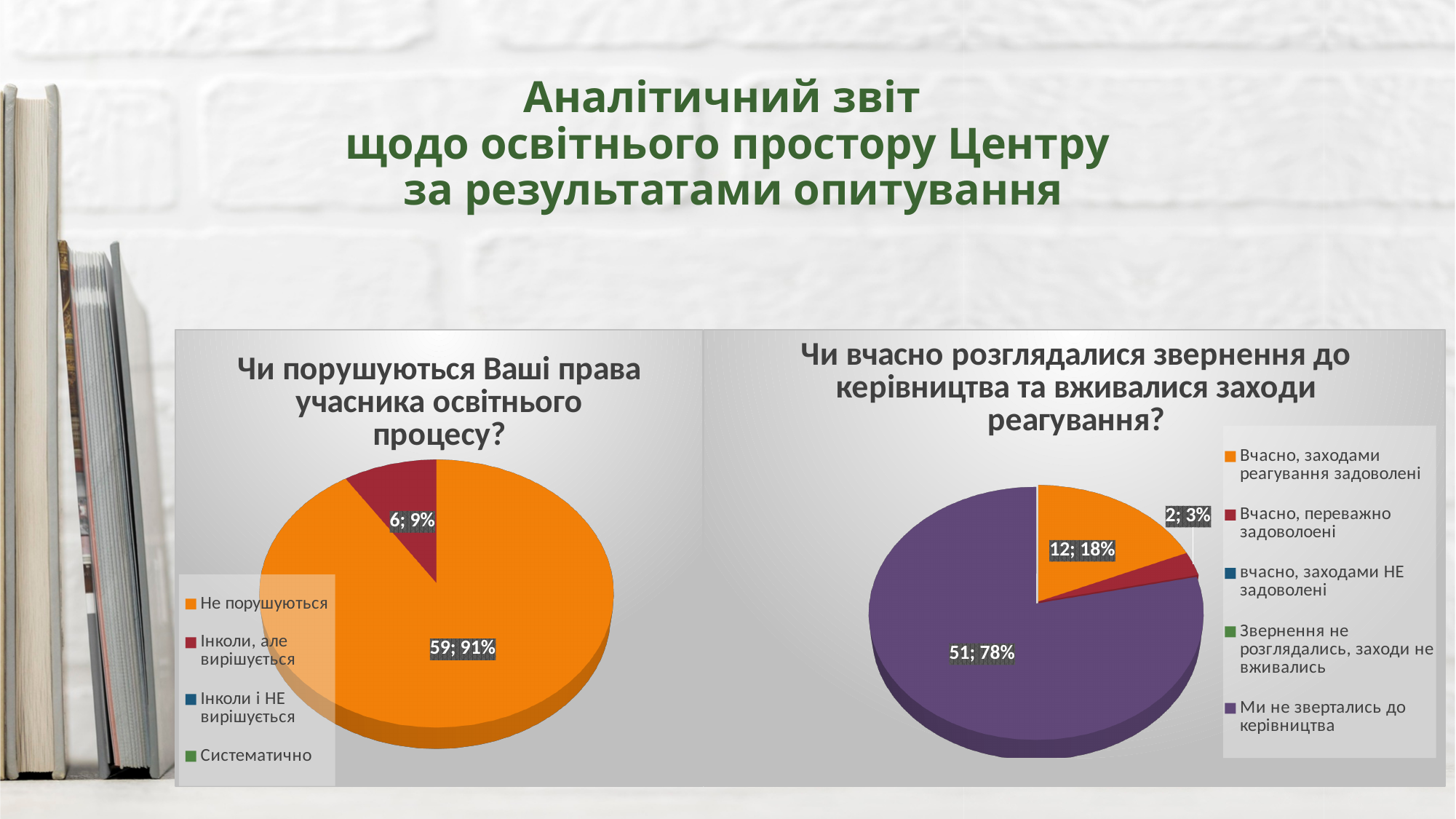
In the chart titled "Чи порушуються Ваші права учасника освітнього процесу?", what is the difference in respondent counts between "Не порушуються" and "Інколи, але вирішується"? 53 In the chart titled "Чи вчасно розглядалися звернення до керівництва та вживалися заходи реагування?", what percentage is shown for "Ми не звертались до керівництва"? 78% In the chart titled "Чи вчасно розглядалися звернення до керівництва та вживалися заходи реагування?", how many entries does the legend list? 5 In the chart titled "Чи порушуються Ваші права учасника освітнього процесу?", how many respondents chose "Інколи, але вирішується"? 6 In the chart titled "Чи порушуються Ваші права учасника освітнього процесу?", which category has the largest slice? Не порушуються In the chart titled "Чи порушуються Ваші права учасника освітнього процесу?", what percentage is shown for "Не порушуються"? 91% In the chart titled "Чи вчасно розглядалися звернення до керівництва та вживалися заходи реагування?", what percentage is shown for "Вчасно, переважно задоволоені"? 3% What type of chart is used for "Чи вчасно розглядалися звернення до керівництва та вживалися заходи реагування?"? Pie chart In the chart titled "Чи вчасно розглядалися звернення до керівництва та вживалися заходи реагування?", which is larger: "Вчасно, заходами реагування задоволені" or "Вчасно, переважно задоволоені"? Вчасно, заходами реагування задоволені In the chart titled "Чи порушуються Ваші права учасника освітнього процесу?", how many entries does the legend list? 4 In the chart titled "Чи вчасно розглядалися звернення до керівництва та вживалися заходи реагування?", which category has the smallest labelled slice? Вчасно, переважно задоволоені In the chart titled "Чи вчасно розглядалися звернення до керівництва та вживалися заходи реагування?", how many respondents chose "Вчасно, заходами реагування задоволені"? 12